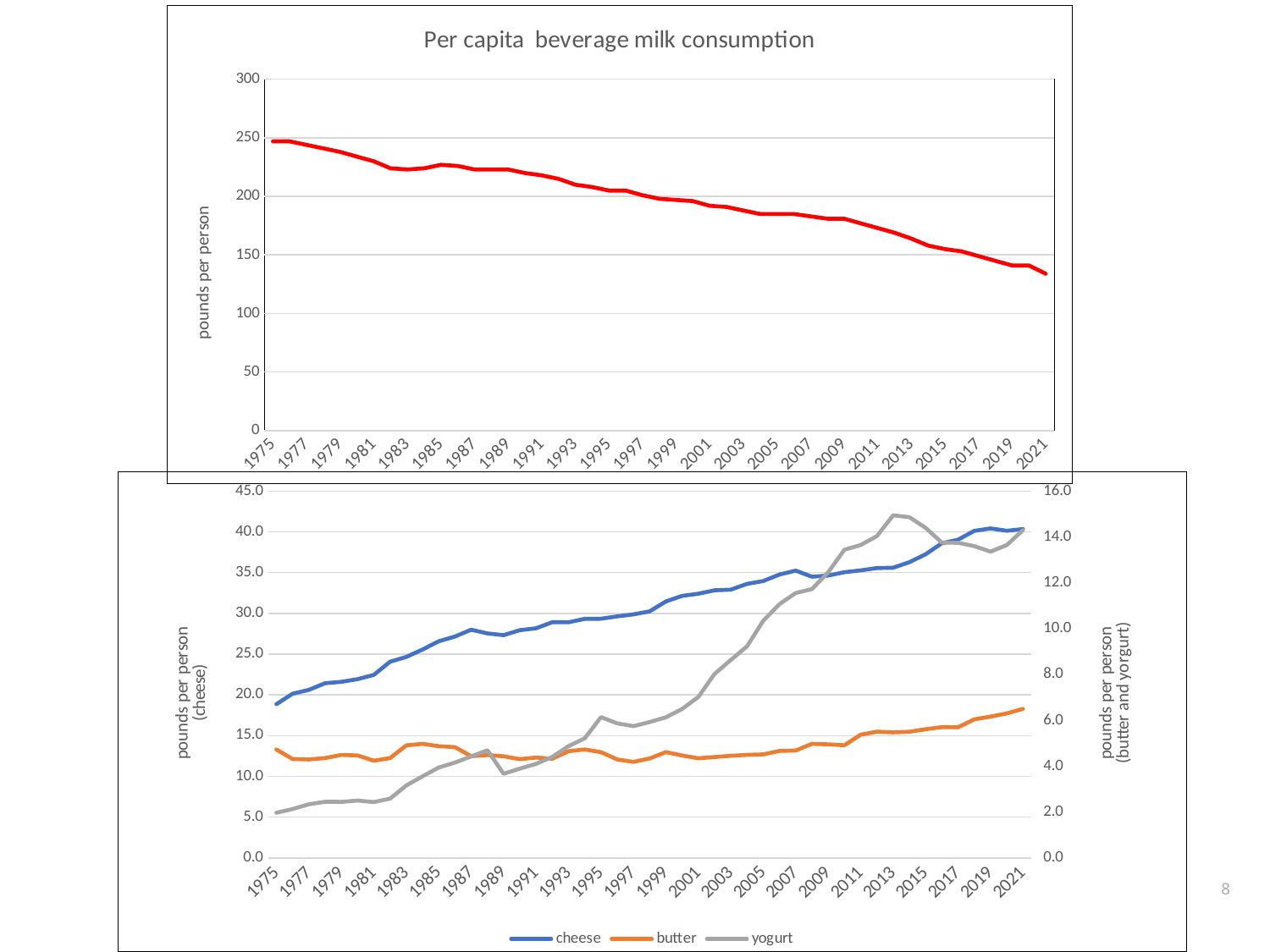
In the top chart 'Per capita beverage milk consumption', do values rise or fall from 1975 to 2021? fall In the bottom chart, is the cheese value for 1975 greater or less than 20.0? less How many series does the legend of the bottom chart list? 3 In the bottom chart, which is larger in 1975, butter or yogurt? butter In the top chart 'Per capita beverage milk consumption', is the value for 2021 greater or less than 150? less In the bottom chart, is the cheese value for 2021 greater or less than 35.0? greater In the bottom chart, which is larger in 2021, butter or yogurt? yogurt What is the y-axis label of the top chart 'Per capita beverage milk consumption'? pounds per person What type of chart is the top chart titled 'Per capita beverage milk consumption'? line chart In the bottom chart, does the cheese series rise or fall from 1975 to 2021? rise What are the series names in the legend of the bottom chart? cheese, butter, yogurt